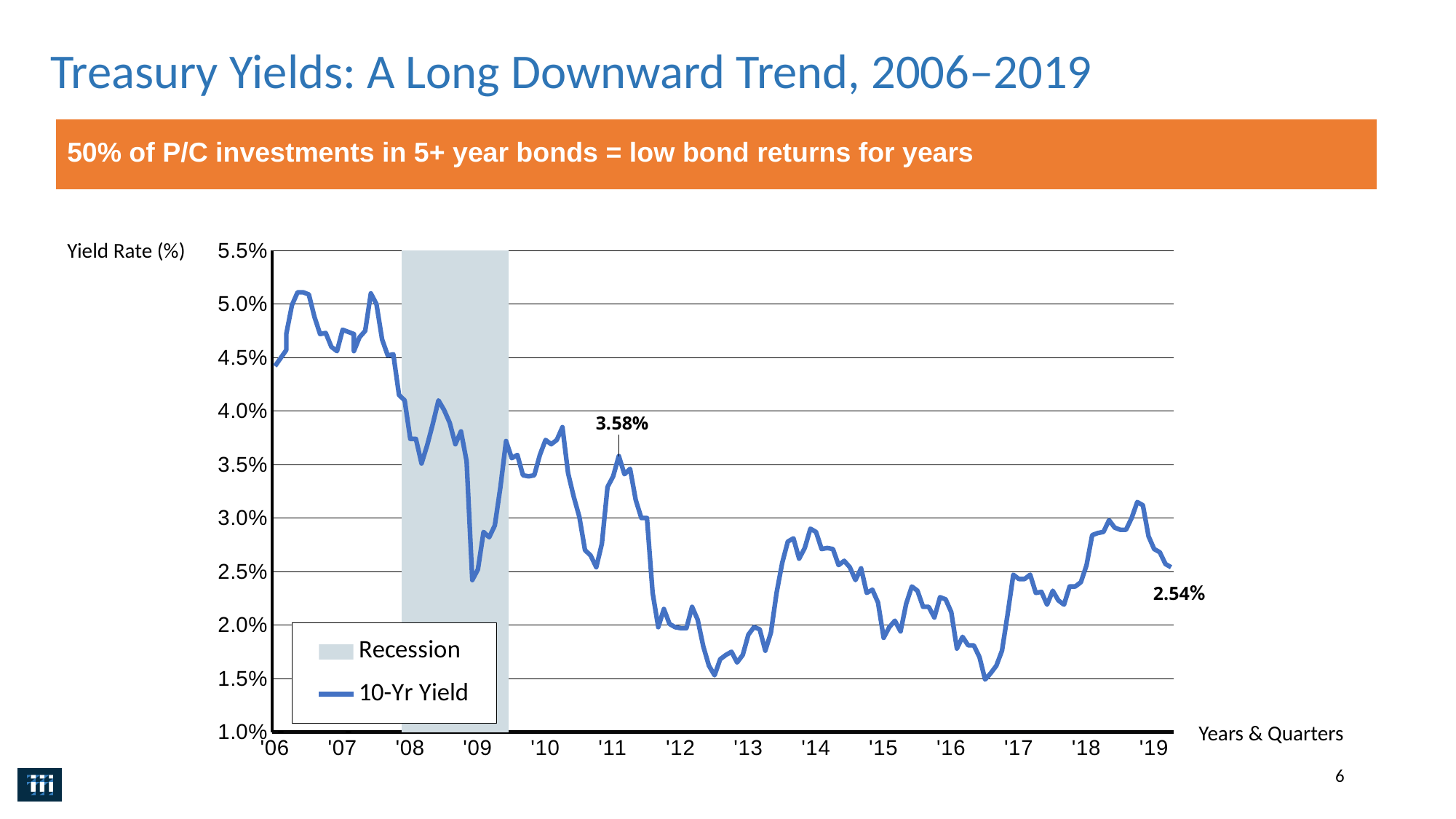
What does the grey shaded area on the chart represent? Recession How many entries does the chart legend list? 2 What is the labeled 10-Yr Yield value at the peak in 2011? 3.58% Is the 10-Yr Yield at the start of '09 greater or less than 3.0%? less How many year labels are shown on the x axis? 14 Overall, does the 10-Yr Yield rise or fall from 2006 to 2019? fall Is the 10-Yr Yield at the start of '06 greater or less than 4.0%? greater What is the labeled 10-Yr Yield value at the end of the series in 2019? 2.54% Which labeled value is larger: the 2011 peak or the 2019 end value? the 2011 peak (3.58%) What is the difference between the labeled 2011 peak (3.58%) and the labeled 2019 value (2.54%)? 1.04 percentage points What kind of chart is shown on the slide? line chart Is the lowest 10-Yr Yield reached during 2012 greater or less than 2.0%? less